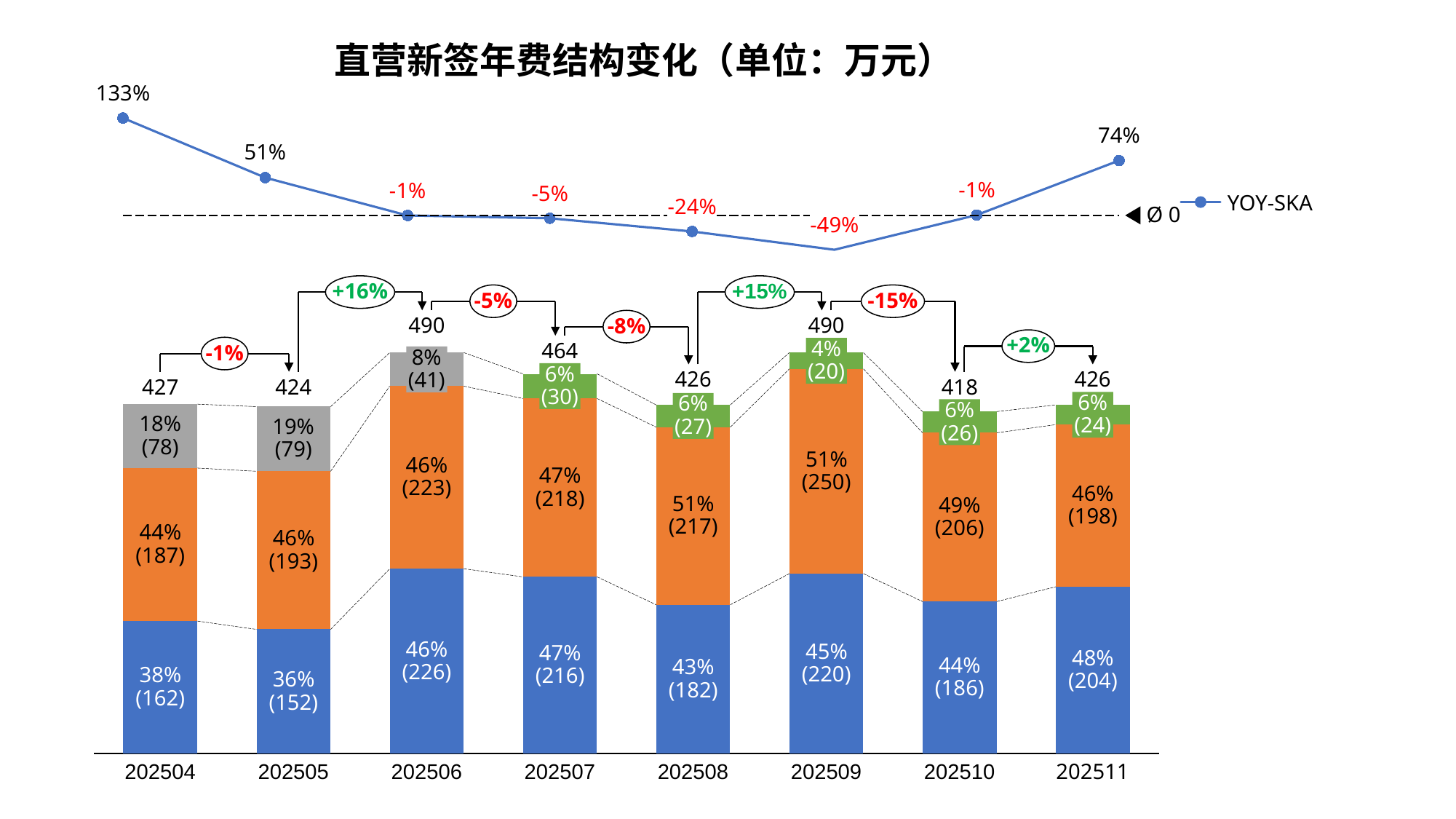
How many months are shown on the x axis? 8 What is the value of the bottom (blue) segment of the bar for 202506? 226 What percentage share does the orange segment have in the 202509 bar? 51% What kind of chart is used for the monthly fee structure at the bottom of the slide? Stacked bar chart What is the YOY-SKA value for 202509? -49% What is the legend entry for the line series at the top of the slide? YOY-SKA Which month has the lowest bar total? 202510 Which month has the highest YOY-SKA value? 202504 What is the difference between the bar totals for 202506 and 202507? 26 Which bar total is larger, 202504 or 202505? 202504 What is the total new-signing annual fee shown above the bar for 202507? 464 Which month has the lowest YOY-SKA value? 202509